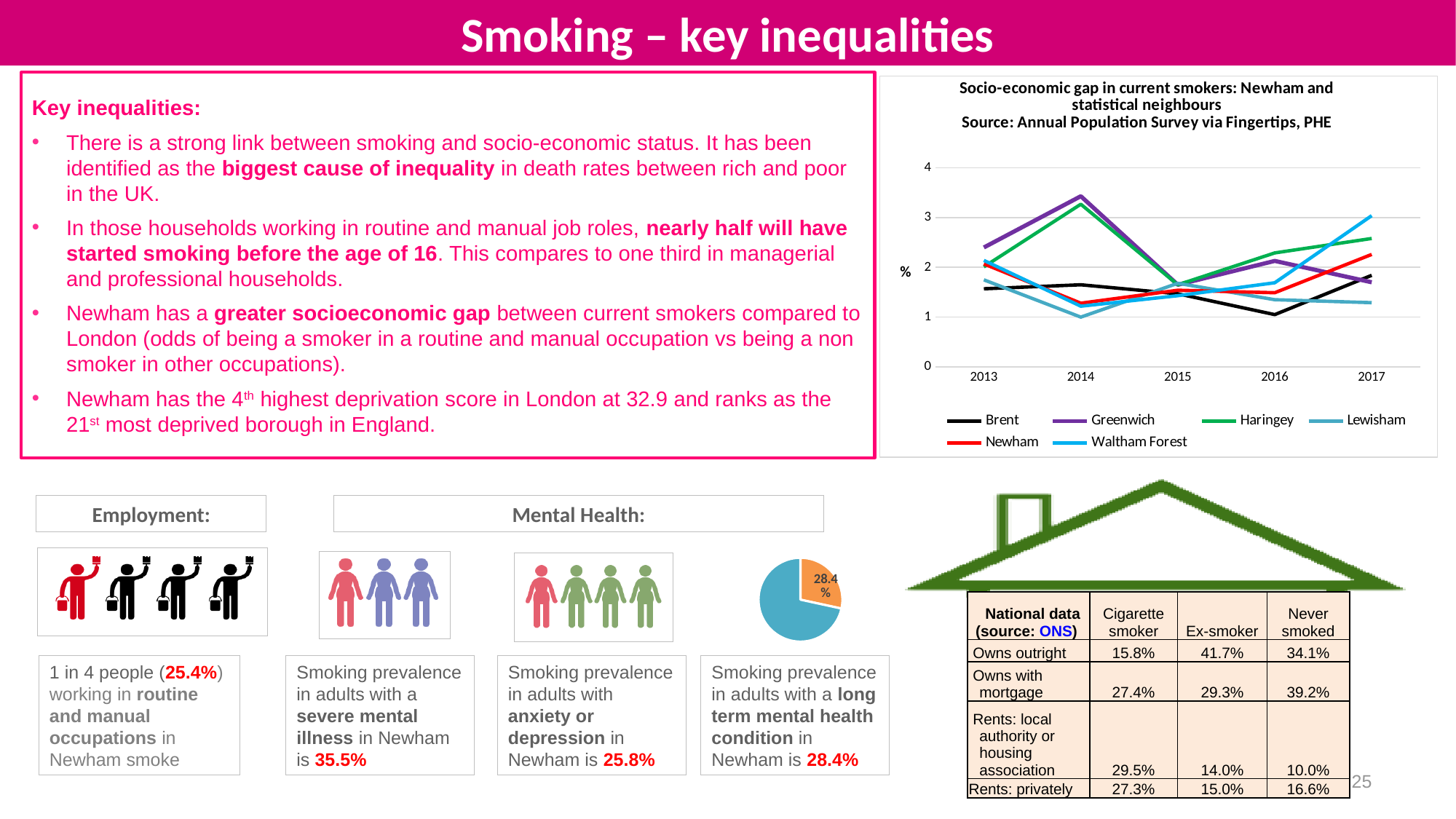
In the 'Socio-economic gap in current smokers' chart, which borough has the highest value in 2017? Waltham Forest In the 'Socio-economic gap in current smokers' chart, does the Waltham Forest line rise or fall from 2015 to 2017? rise How many years are shown on the x axis of the 'Socio-economic gap in current smokers' chart? 5 What is the source named in the title of the 'Socio-economic gap in current smokers' chart? Annual Population Survey via Fingertips, PHE What kind of chart is the 'Socio-economic gap in current smokers' chart? line chart In the 'Socio-economic gap in current smokers' chart, is the value for Newham in 2017 greater or less than 2? greater In the 'Socio-economic gap in current smokers' chart, which is larger in 2014: Greenwich or Brent? Greenwich In the 'Socio-economic gap in current smokers' chart, is the value for Brent in 2013 greater or less than 2? less In the 'Socio-economic gap in current smokers' chart, is the value for Greenwich in 2014 greater or less than 3? greater In the 'Socio-economic gap in current smokers' chart, which borough has the lowest value in 2014? Lewisham How many series does the legend of the 'Socio-economic gap in current smokers' chart list? 6 In the small pie chart in the Mental Health section, what share is shown on the labelled slice? 28.4%